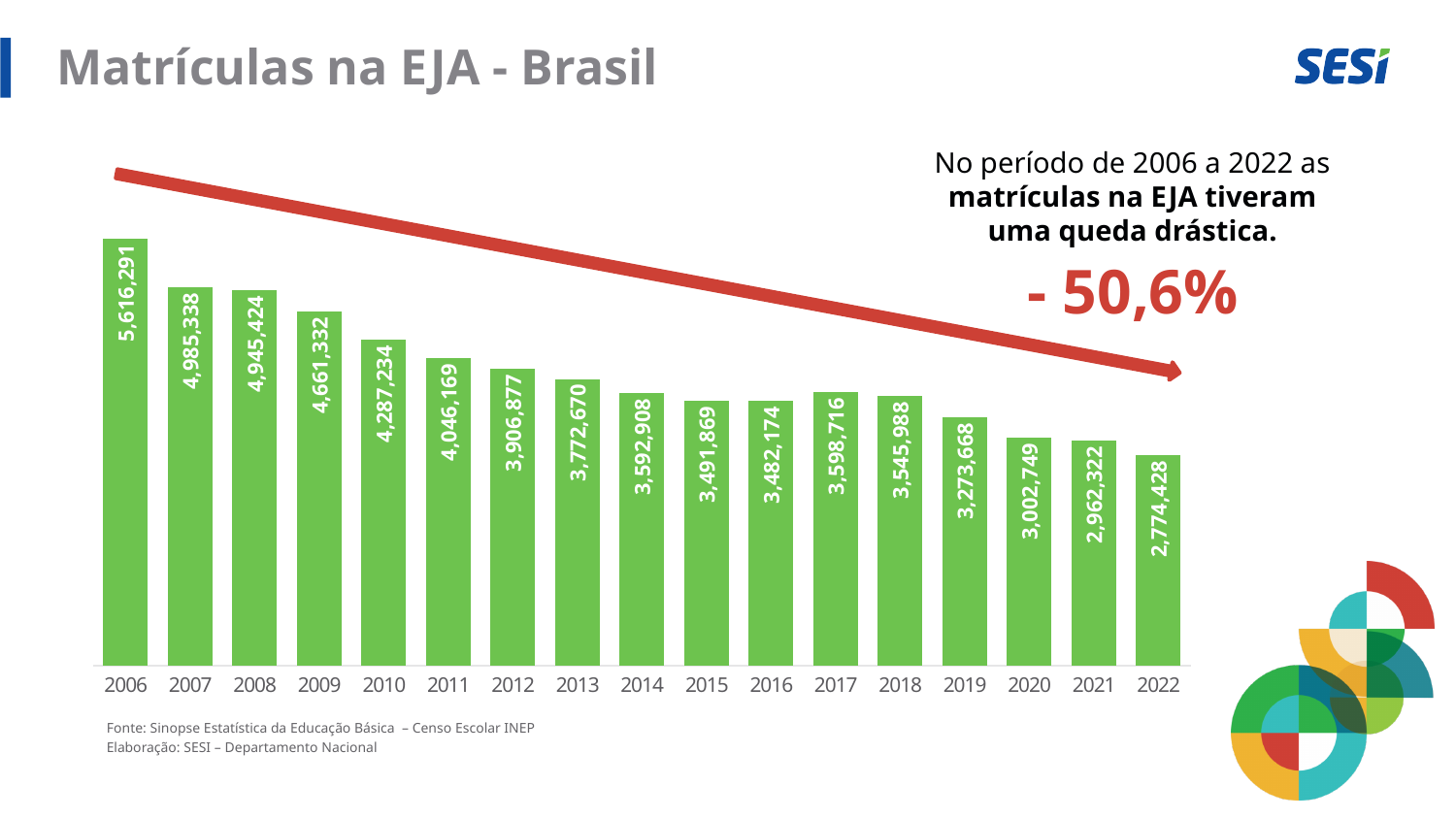
What is the number of EJA enrolments in 2006? 5,616,291 Which year has the highest number of enrolments? 2006 What is the value shown for 2014? 3,592,908 How many years (bars) are shown in the chart? 17 Which year has the lowest number of enrolments? 2022 Which year has a larger value, 2016 or 2017? 2017 What is the number of EJA enrolments in 2022? 2,774,428 What is the difference between the 2007 and 2008 values? 39,914 What percentage change is highlighted in red on the slide? - 50,6% What is the difference between the 2006 and 2022 values? 2,841,863 What type of chart is shown on the slide? bar chart Do the values generally rise or fall from 2006 to 2022? fall